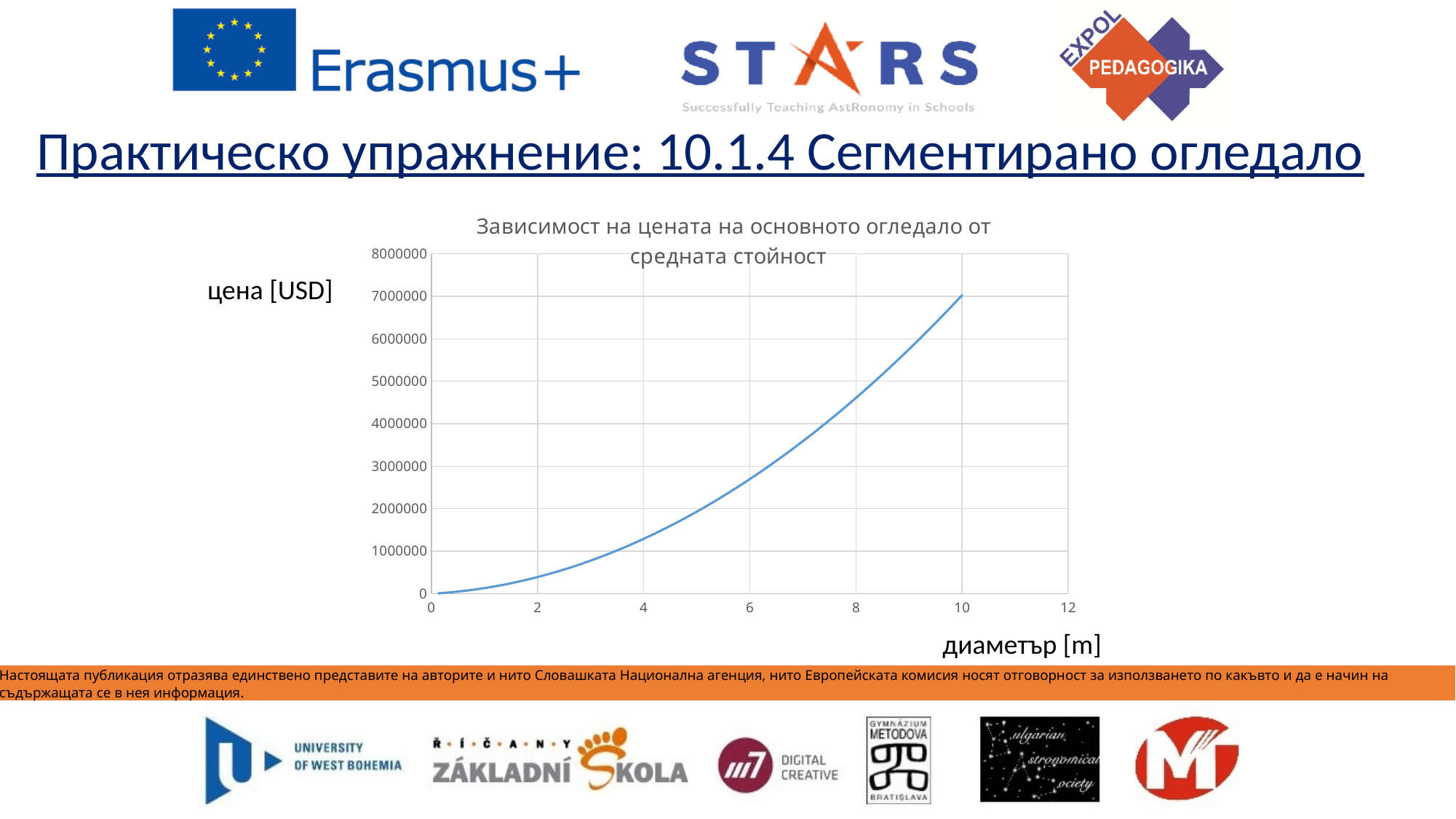
Is the price at a diameter of 4 m greater or less than 2000000? less What kind of chart is shown on the slide? line chart Is the price at a diameter of 10 m greater or less than 6000000? greater Is the price at a diameter of 2 m greater or less than 1000000? less What is the label of the horizontal axis of the chart? диаметър [m] Does the price rise or fall as the diameter increases along the x axis? rises What is the label of the vertical axis of the chart? цена [USD] At which diameter shown on the chart is the price highest? 10